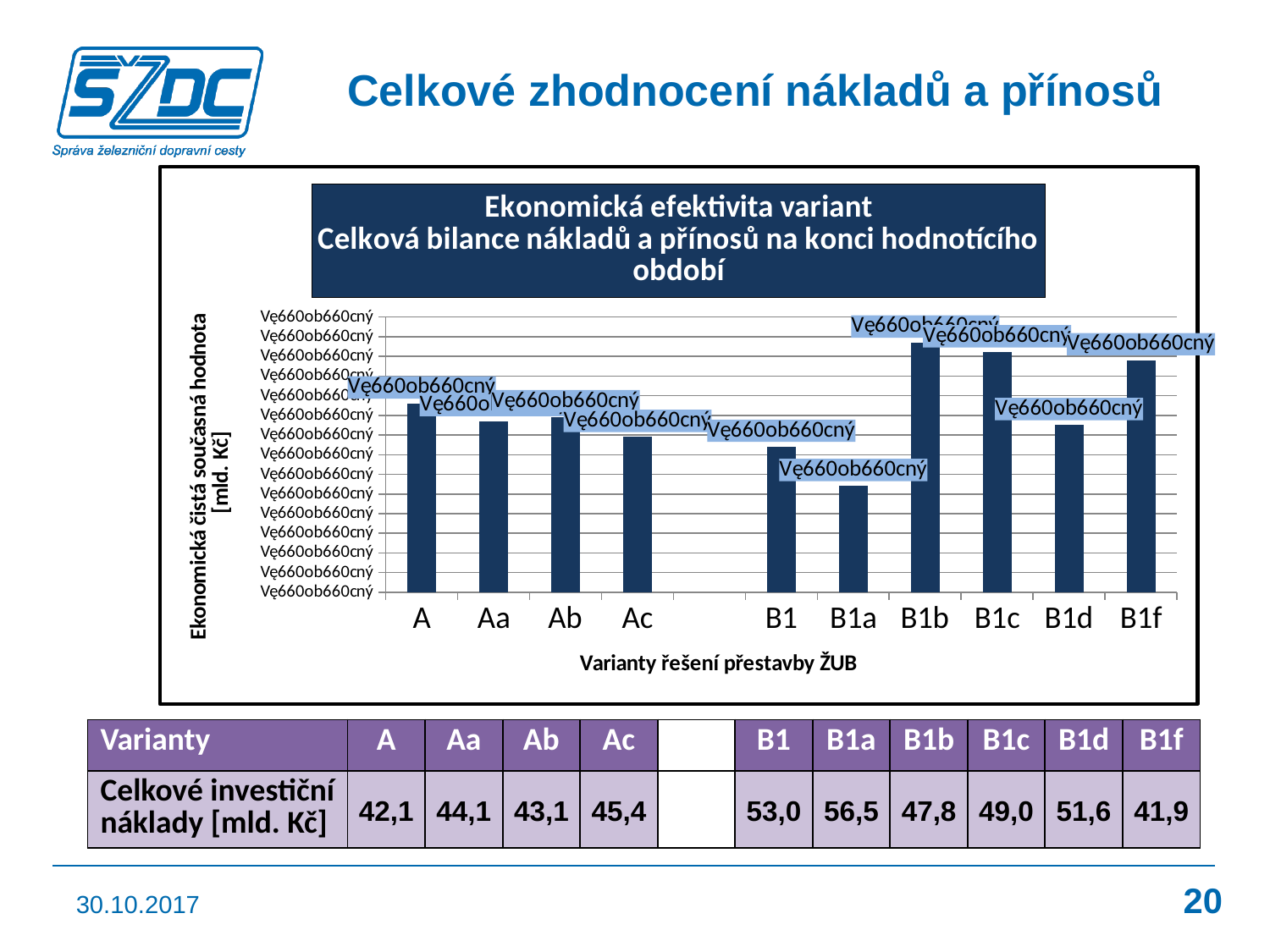
What is the label of the x axis of the chart? Varianty řešení přestavby ŽUB Which has the taller bar in the chart, B1f or B1d? B1f Which variant has the lowest bar in the chart? B1a Which variant has the highest bar in the chart? B1b How many variants (categories) are plotted on the x axis of the chart? 10 What kind of chart is shown on the slide? bar chart Which has the taller bar in the chart, B1b or B1c? B1b Which has the taller bar in the chart, B1 or B1a? B1 What is the label of the y axis of the chart? Ekonomická čistá současná hodnota [mld. Kč]